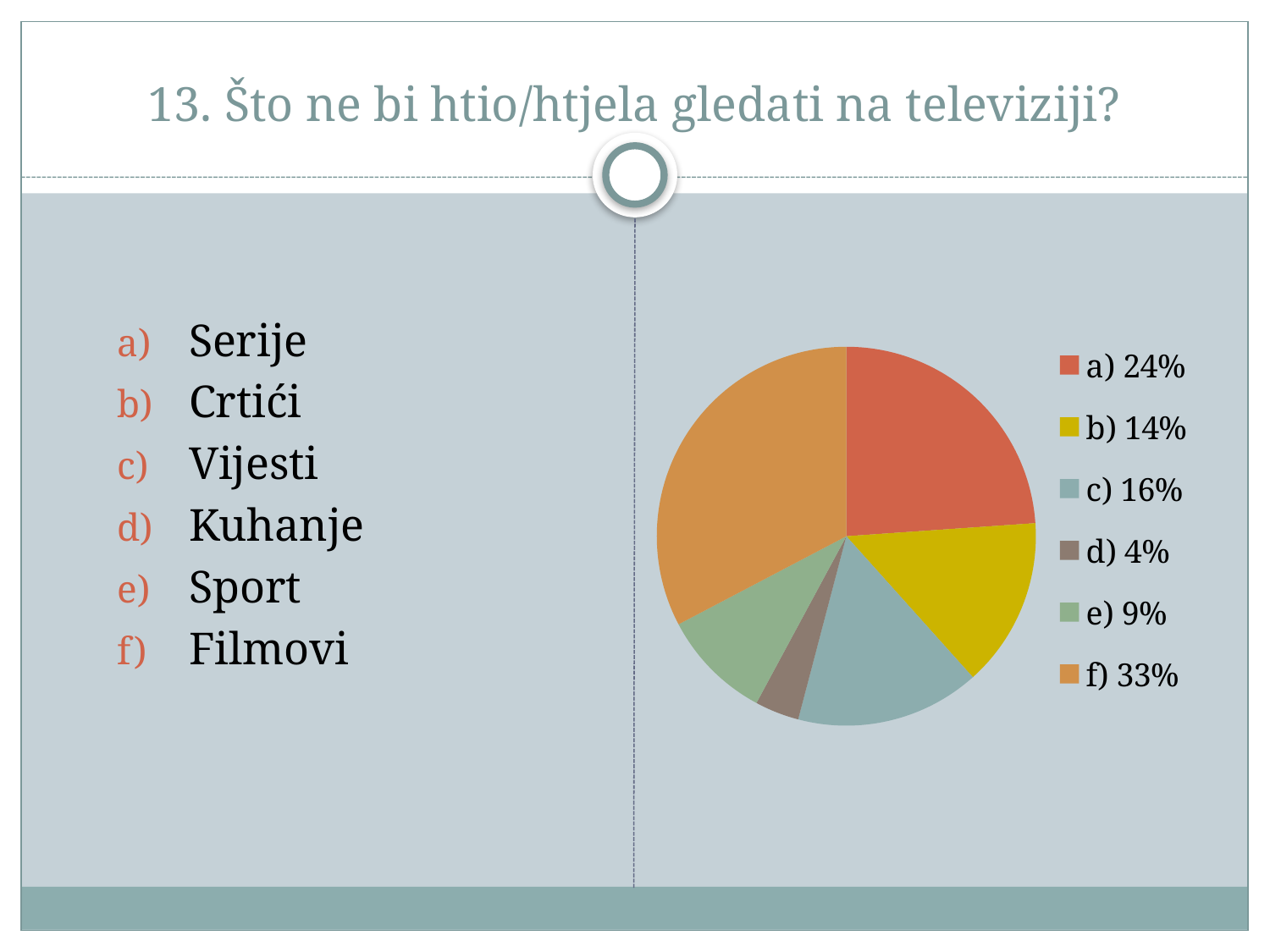
How many slices does the pie chart have? 6 What percentage does the legend show for category a)? 24% What is the difference in percentage points between category f) and category a)? 9 Which category has the smallest share of the pie? d) 4% What percentage does the legend show for category d)? 4% What colour is the slice for category f) 33%? orange What kind of chart is shown on the slide? pie chart What is the combined percentage of categories d) and e)? 13% How many entries does the legend list? 6 What percentage does the legend show for category c)? 16% Which is larger, the share for category b) or the share for category c)? c) 16% Which category has the largest share of the pie? f) 33%